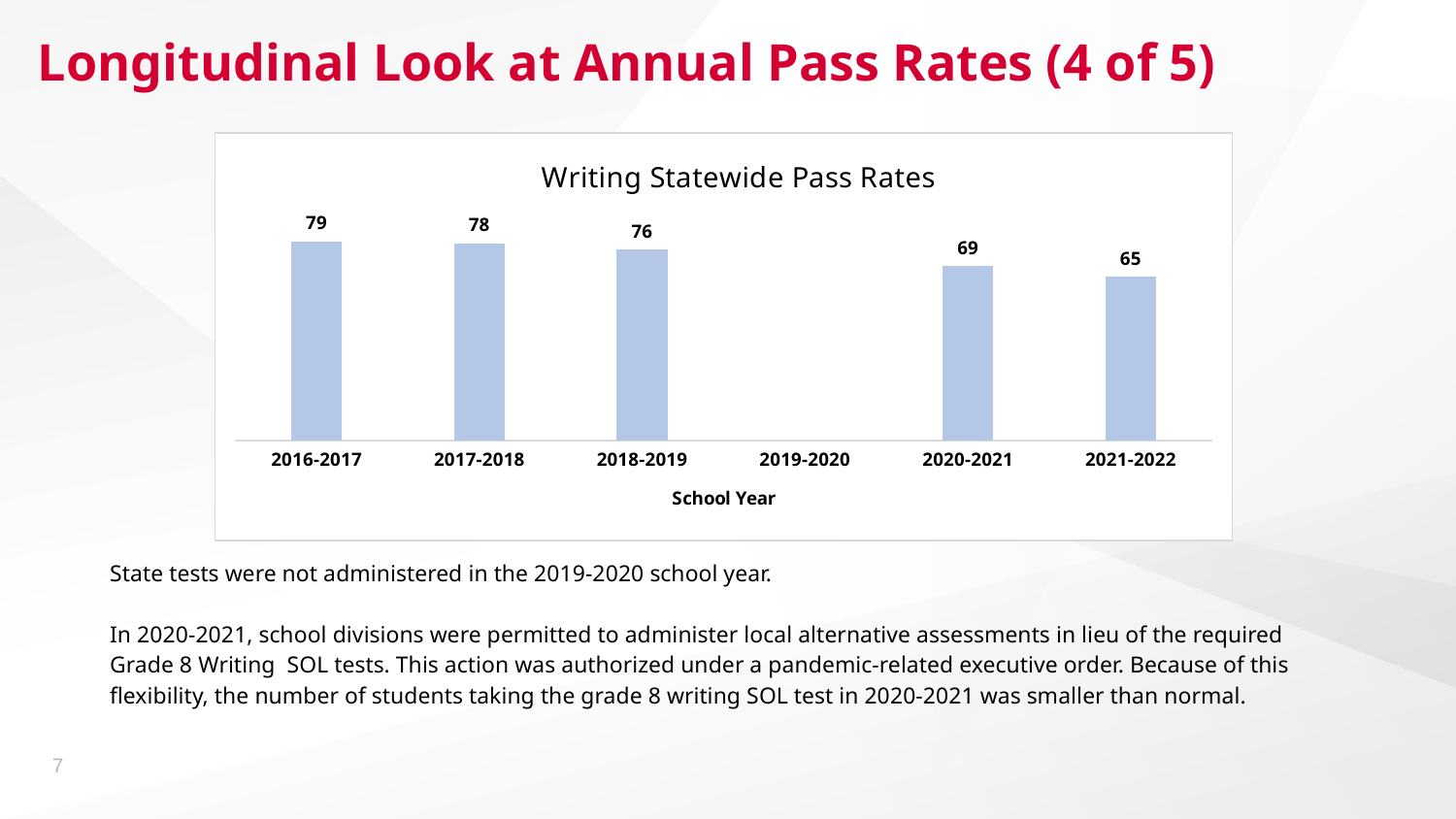
Do the writing statewide pass rates rise or fall from 2016-2017 to 2021-2022? Fall Which school year has the lowest writing statewide pass rate shown? 2021-2022 What is the title of the chart? Writing Statewide Pass Rates What is the writing statewide pass rate for 2021-2022? 65 Which school year has the highest writing statewide pass rate? 2016-2017 What is the difference between the pass rates for 2016-2017 and 2021-2022? 14 Which is larger, the pass rate for 2017-2018 or for 2020-2021? 2017-2018 What is the writing statewide pass rate for 2016-2017? 79 What is the difference between the pass rates for 2018-2019 and 2020-2021? 7 How many school years are labeled on the x axis of the chart? 6 What is the writing statewide pass rate for 2018-2019? 76 What kind of chart is shown on the slide? Bar chart